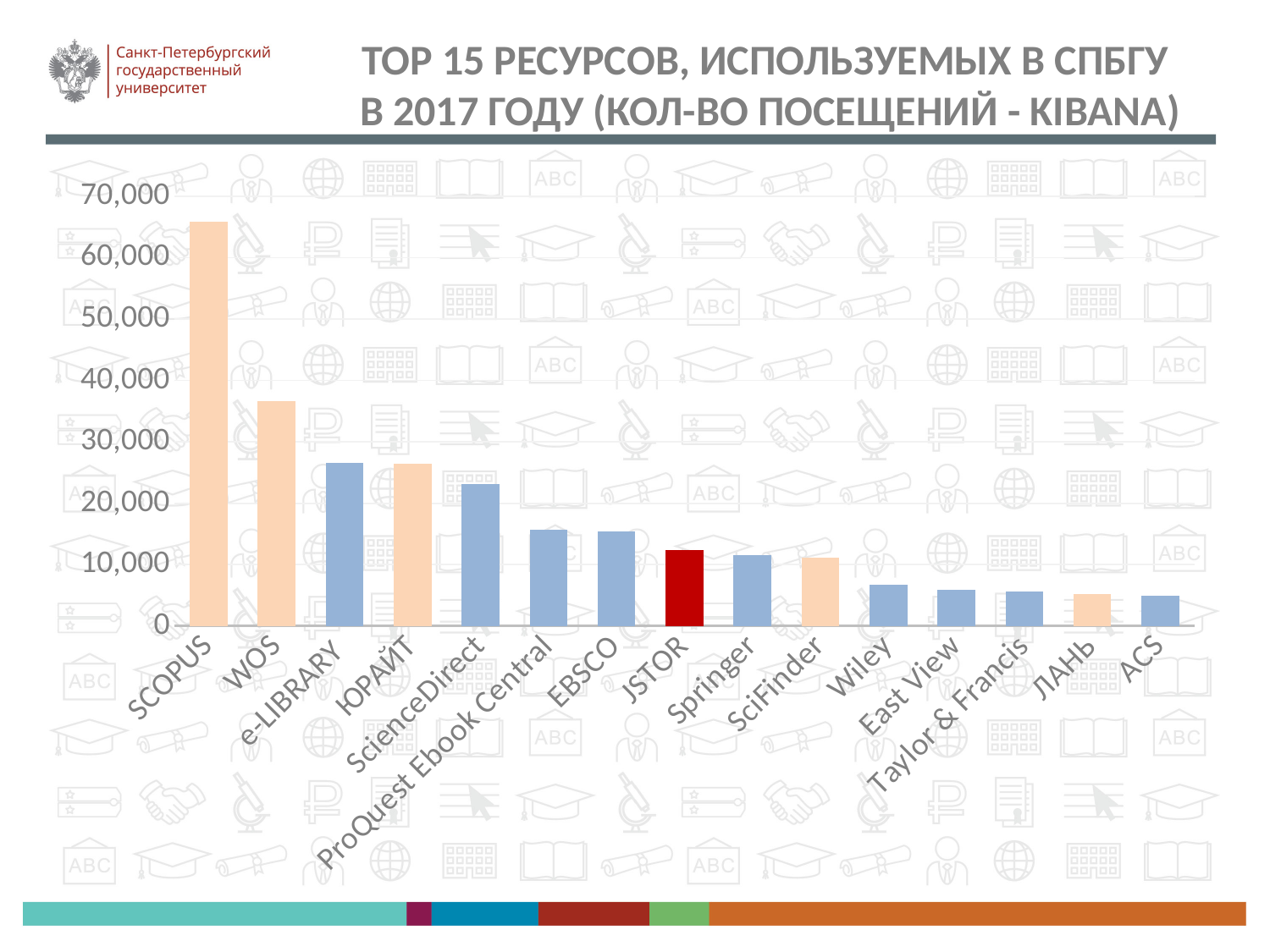
Is the value for Wiley greater or less than 10,000? less Is the value for JSTOR greater or less than 10,000? greater How many resources (categories) are shown on the x axis of the chart? 15 Which has a larger value, WOS or ScienceDirect? WOS Is the value for SCOPUS greater or less than 60,000? greater Which resource has the highest number of visits in the chart? SCOPUS Which has a larger value, JSTOR or Wiley? JSTOR Do the values rise or fall moving from left to right along the x axis? fall What kind of chart is shown on the slide? bar chart Which resource's bar is coloured red in the chart? JSTOR